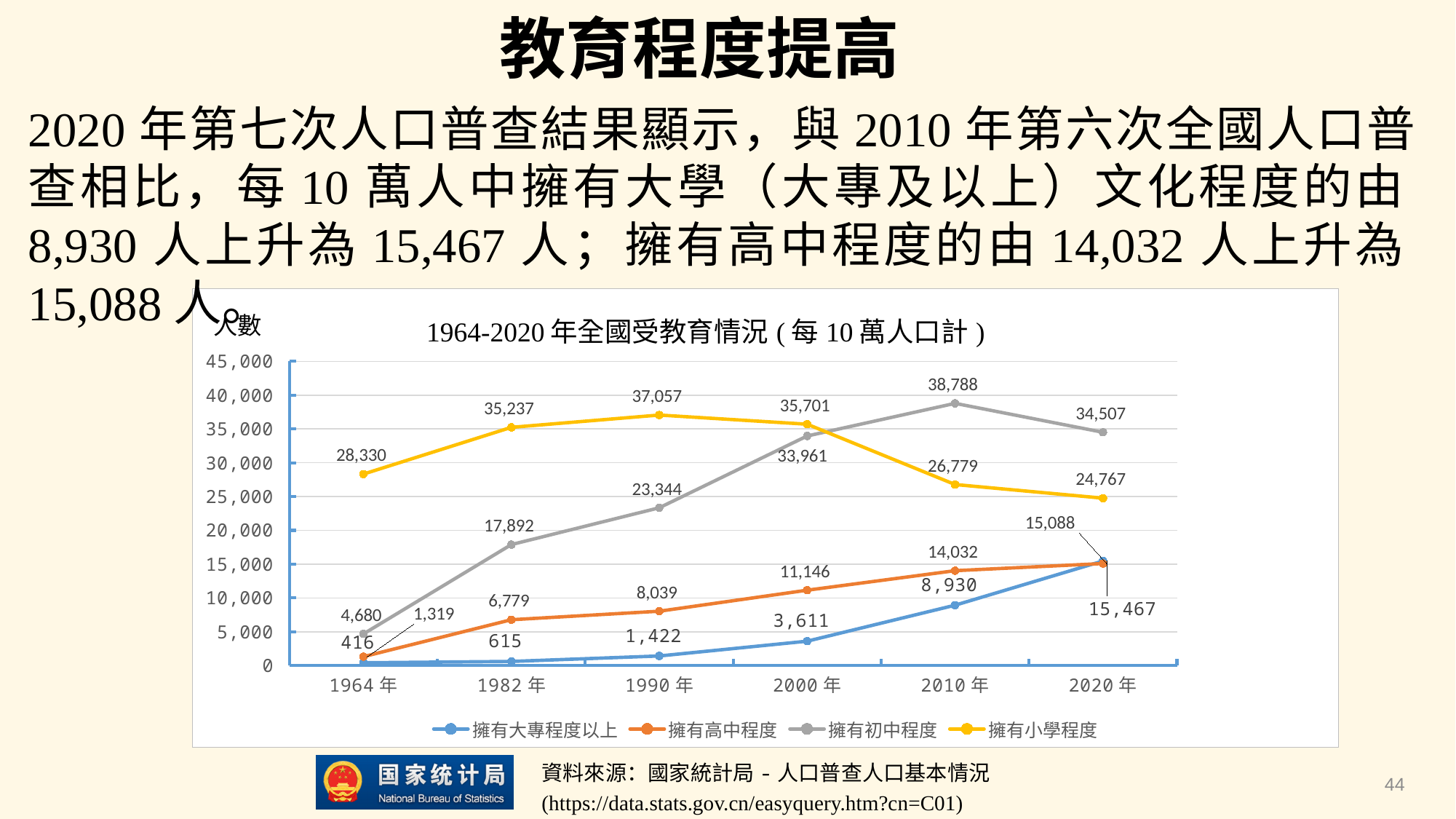
What is the value for 擁有初中程度 in 2010 年? 38,788 What is the value for 擁有大專程度以上 in 2000 年? 3,611 How many years are plotted along the x axis? 6 How many series does the legend list? 4 In which year does 擁有小學程度 reach its highest value? 1990 年 Does 擁有大專程度以上 rise or fall from 1964 年 to 2020 年? rise In which year is 擁有大專程度以上 at its lowest value? 1964 年 What is the value for 擁有小學程度 in 1990 年? 37,057 What is the title of the chart? 1964-2020 年全國受教育情況 ( 每 10 萬人口計 ) What is the difference between 擁有高中程度 in 2020 年 and in 2010 年? 1,056 What type of chart is shown on the slide? line chart Which is larger in 2020 年: 擁有初中程度 or 擁有小學程度? 擁有初中程度